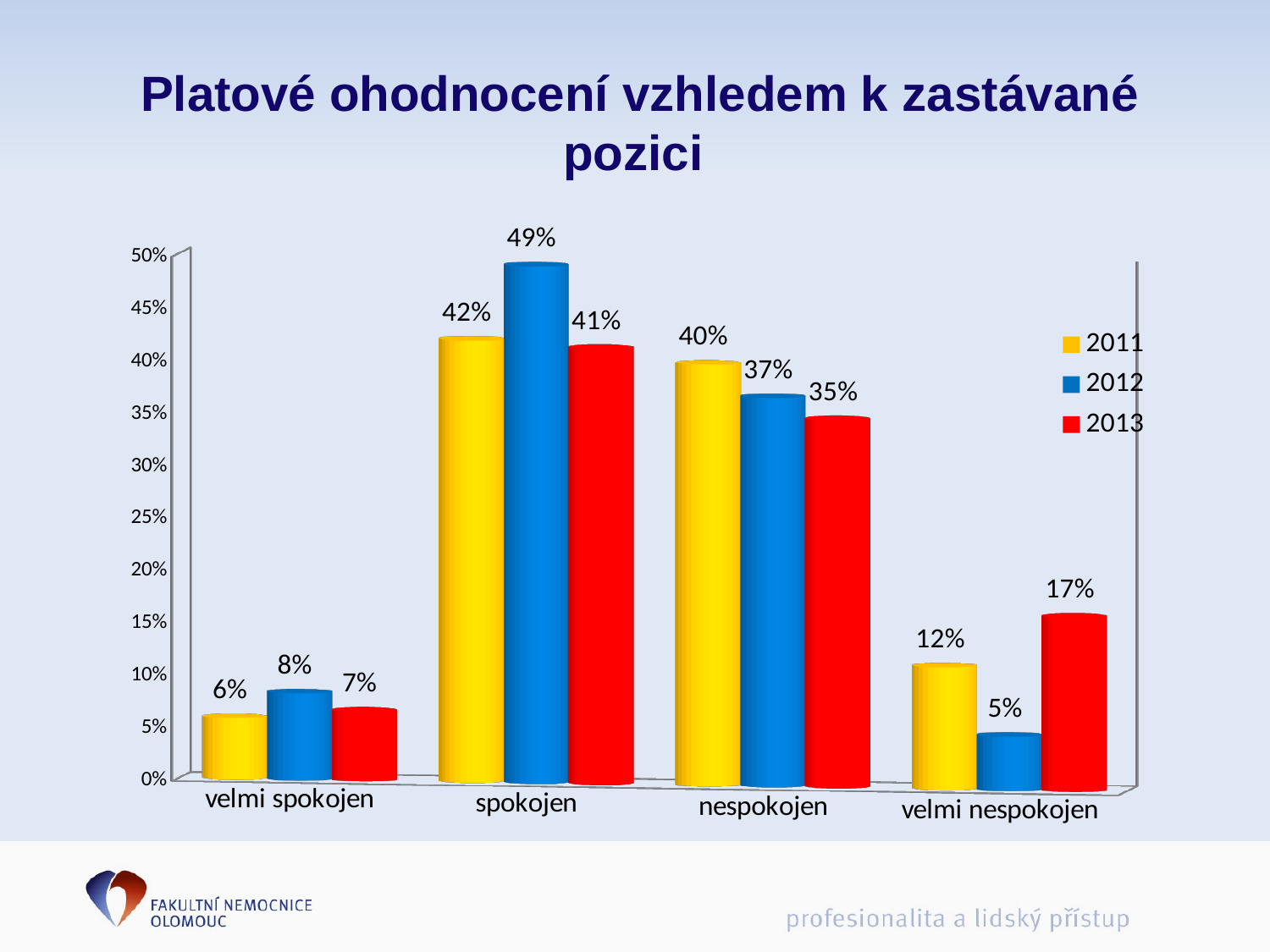
Which category has the highest value for the 2013 series? spokojen How many series does the legend list? 3 What kind of chart is shown on the slide? bar chart How many categories are shown on the x axis? 4 What is the value for 2013 in the "velmi nespokojen" category? 17% What is the value for 2012 in the "spokojen" category? 49% Is the value for 2013 in the "nespokojen" category greater or less than 30%? greater Which colour represents the 2012 series in the legend? blue What is the difference between the 2012 and 2011 values in the "spokojen" category? 7% What is the value for 2011 in the "nespokojen" category? 40% Which category has the lowest value for the 2012 series? velmi nespokojen Which is larger in the "velmi nespokojen" category: the 2011 value or the 2013 value? 2013